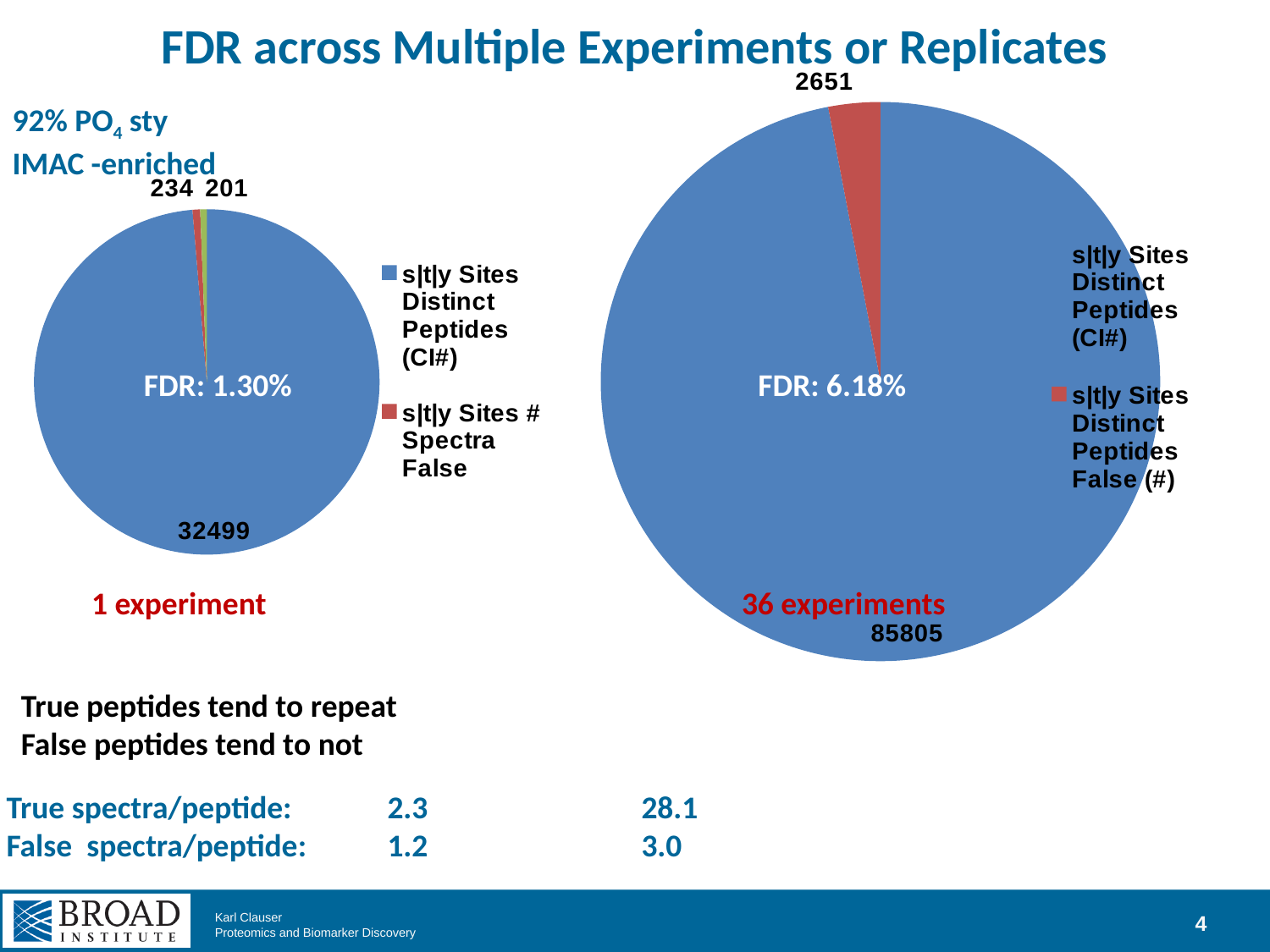
What FDR value is printed on the right pie chart (36 experiments)? 6.18% In the right pie chart (36 experiments), what is the value for s|t|y Sites Distinct Peptides False (#)? 2651 In the right pie chart (36 experiments), which category has the largest slice? s|t|y Sites Distinct Peptides (CI#) How many slices does the left pie chart (1 experiment) have? 3 In the right pie chart (36 experiments), what is the difference between the s|t|y Sites Distinct Peptides (CI#) value and the s|t|y Sites Distinct Peptides False (#) value? 83154 In the left pie chart (1 experiment), what is the value of the largest slice? 32499 Which chart has the larger value for its largest slice, the left pie chart (1 experiment) or the right pie chart (36 experiments)? The right pie chart (36 experiments) How many entries does the legend of the right pie chart (36 experiments) list? 2 In the right pie chart (36 experiments), what is the total of the two labelled slices? 88456 In the right pie chart (36 experiments), which category has the smallest slice? s|t|y Sites Distinct Peptides False (#) What kind of charts are shown on the slide? Pie charts In the right pie chart (36 experiments), what is the value for s|t|y Sites Distinct Peptides (CI#)? 85805